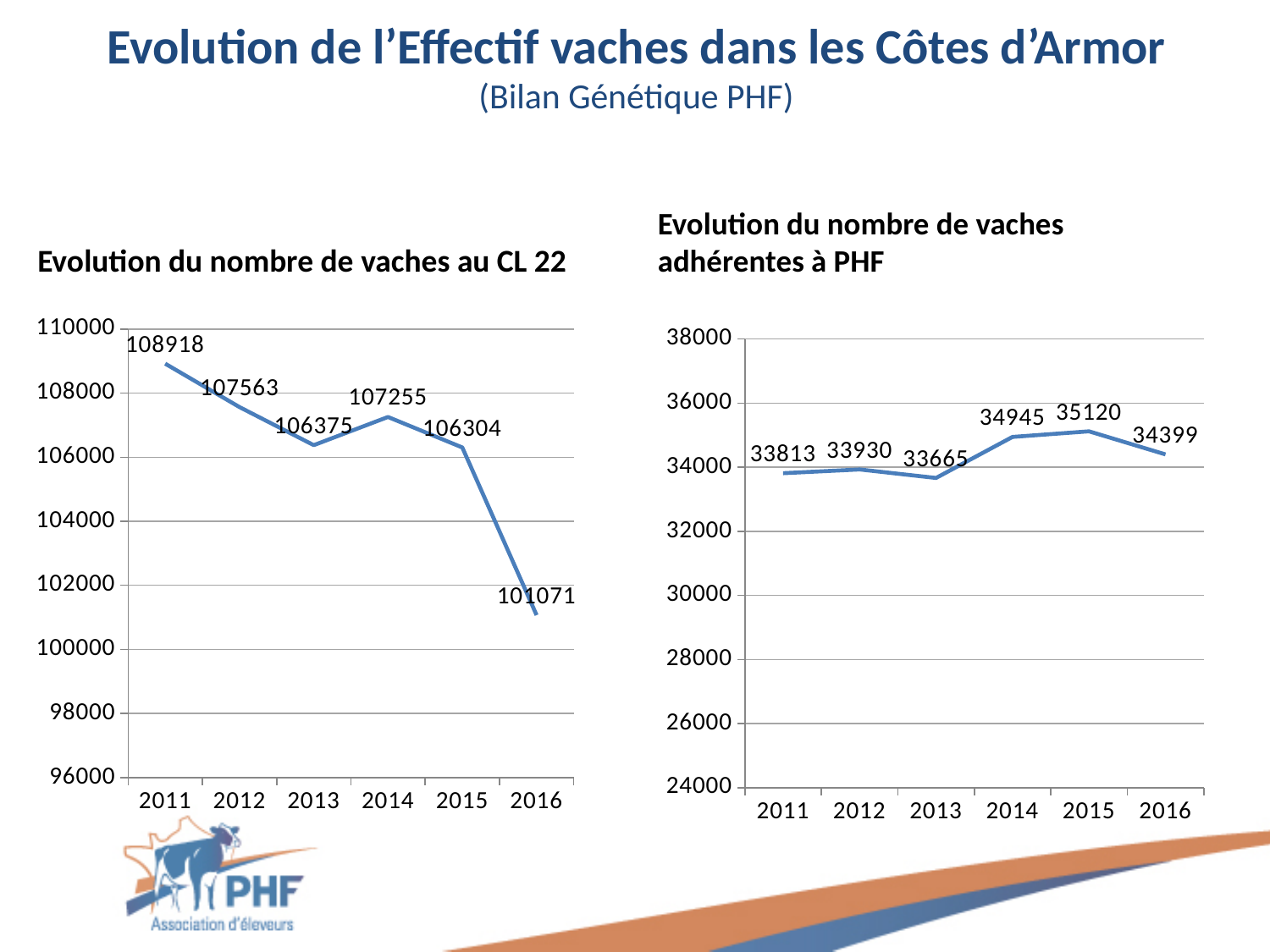
In the chart 'Evolution du nombre de vaches au CL 22', what is the value for 2016? 101071 In the chart 'Evolution du nombre de vaches adhérentes à PHF', which year has the highest value? 2015 In the chart 'Evolution du nombre de vaches adhérentes à PHF', what is the value for 2015? 35120 In the chart 'Evolution du nombre de vaches adhérentes à PHF', which is larger, the value for 2014 or the value for 2016? 2014 In the chart 'Evolution du nombre de vaches adhérentes à PHF', what is the difference between the 2015 and 2016 values? 721 In the chart 'Evolution du nombre de vaches au CL 22', what is the value for 2011? 108918 In the chart 'Evolution du nombre de vaches au CL 22', what is the difference between the 2015 and 2016 values? 5233 In the chart 'Evolution du nombre de vaches adhérentes à PHF', which year has the lowest value? 2013 What kind of chart is 'Evolution du nombre de vaches adhérentes à PHF'? line chart In the chart 'Evolution du nombre de vaches au CL 22', is the value for 2014 greater or less than 106000? greater How many years are plotted in the chart 'Evolution du nombre de vaches au CL 22'? 6 In the chart 'Evolution du nombre de vaches au CL 22', which year has the lowest value? 2016